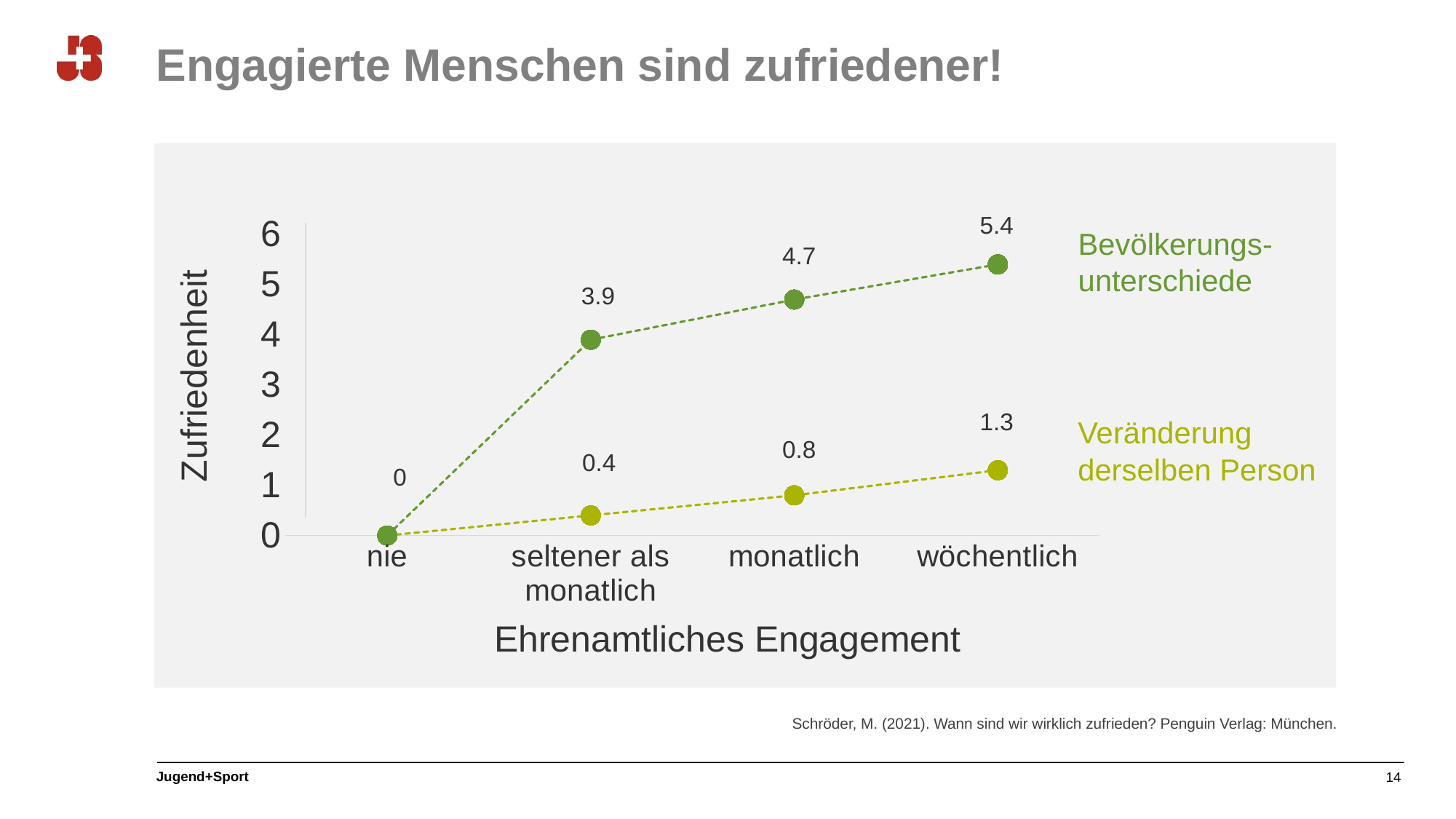
What is the value for 'seltener als monatlich' in the 'Bevölkerungsunterschiede' series? 3.9 What is the value for 'monatlich' in the 'Veränderung derselben Person' series? 0.8 What kind of chart is shown on the slide? line chart Which is larger for 'monatlich': the 'Bevölkerungsunterschiede' value or the 'Veränderung derselben Person' value? Bevölkerungsunterschiede What is the value for 'wöchentlich' in the 'Bevölkerungsunterschiede' series? 5.4 Which category has the highest value in the 'Bevölkerungsunterschiede' series? wöchentlich What is the value for 'nie'? 0 How many categories are shown on the x axis? 4 Which category has the lowest value in the 'Veränderung derselben Person' series? nie Do the values of the 'Veränderung derselben Person' series rise or fall from 'nie' to 'wöchentlich'? rise What is the difference between the 'Bevölkerungsunterschiede' and 'Veränderung derselben Person' values for 'wöchentlich'? 4.1 How many series are plotted in the chart? 2